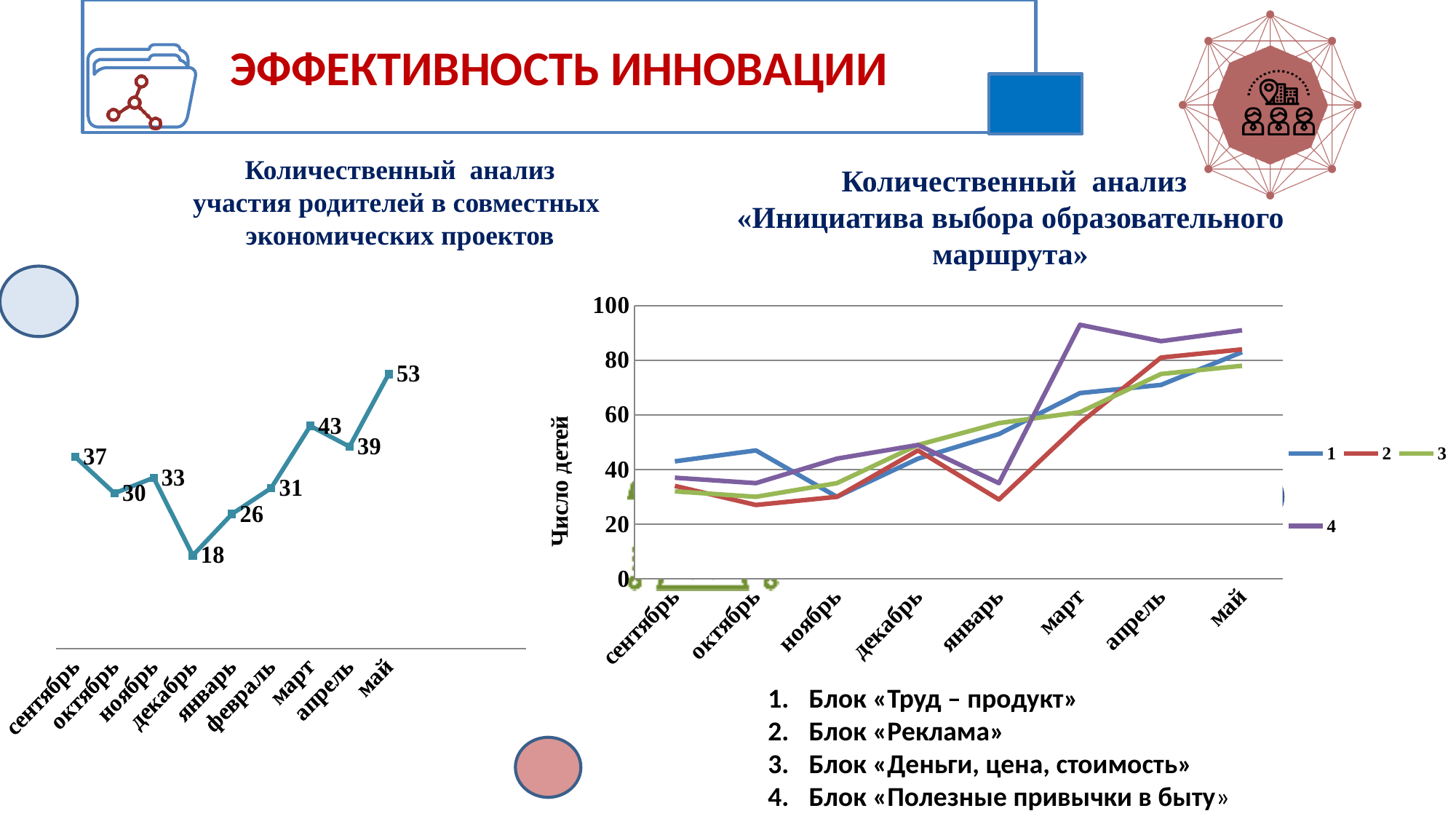
How many series does the legend of the right chart (Инициатива выбора образовательного маршрута) list? 4 In the right chart, is the value of series 2 for январь greater or less than 40? less In the left chart (Количественный анализ участия родителей в совместных экономических проектах), what is the value for декабрь? 18 What kind of chart is the left chart? line chart In the left chart, what is the value for май? 53 How many months are plotted in the left chart? 9 In the left chart, which month has the lowest value? декабрь What is the y-axis label of the right chart? Число детей In the left chart, which month has the highest value? май In the left chart, which is larger, the value for сентябрь or the value for ноябрь? сентябрь In the left chart, what is the difference between the values for март and апрель? 4 In the right chart, is the value of series 4 for март greater or less than 80? greater